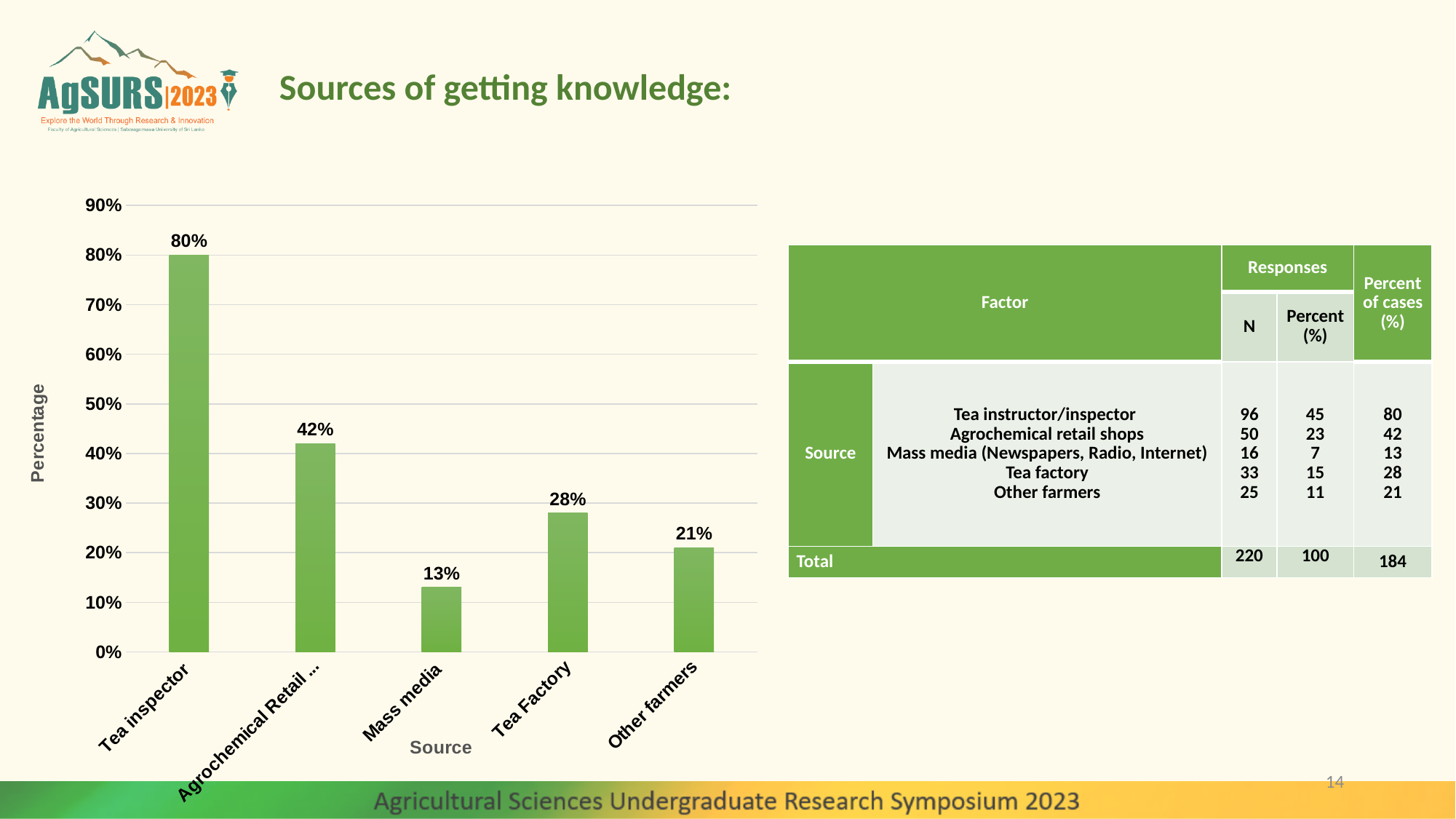
What is the difference between the values for Tea Factory and Other farmers? 7% What is the value for Tea inspector? 80% What is the value for Tea Factory? 28% What kind of chart is shown on the slide? Bar chart What is the difference between the values for Tea inspector and Tea Factory? 52% What is the label of the y axis of the chart? Percentage What is the value for Other farmers? 21% Which source has the highest percentage? Tea inspector What is the value for Mass media? 13% Which source has the lowest percentage? Mass media How many sources are shown on the x axis of the chart? 5 Which is larger, the value for Tea Factory or the value for Mass media? Tea Factory